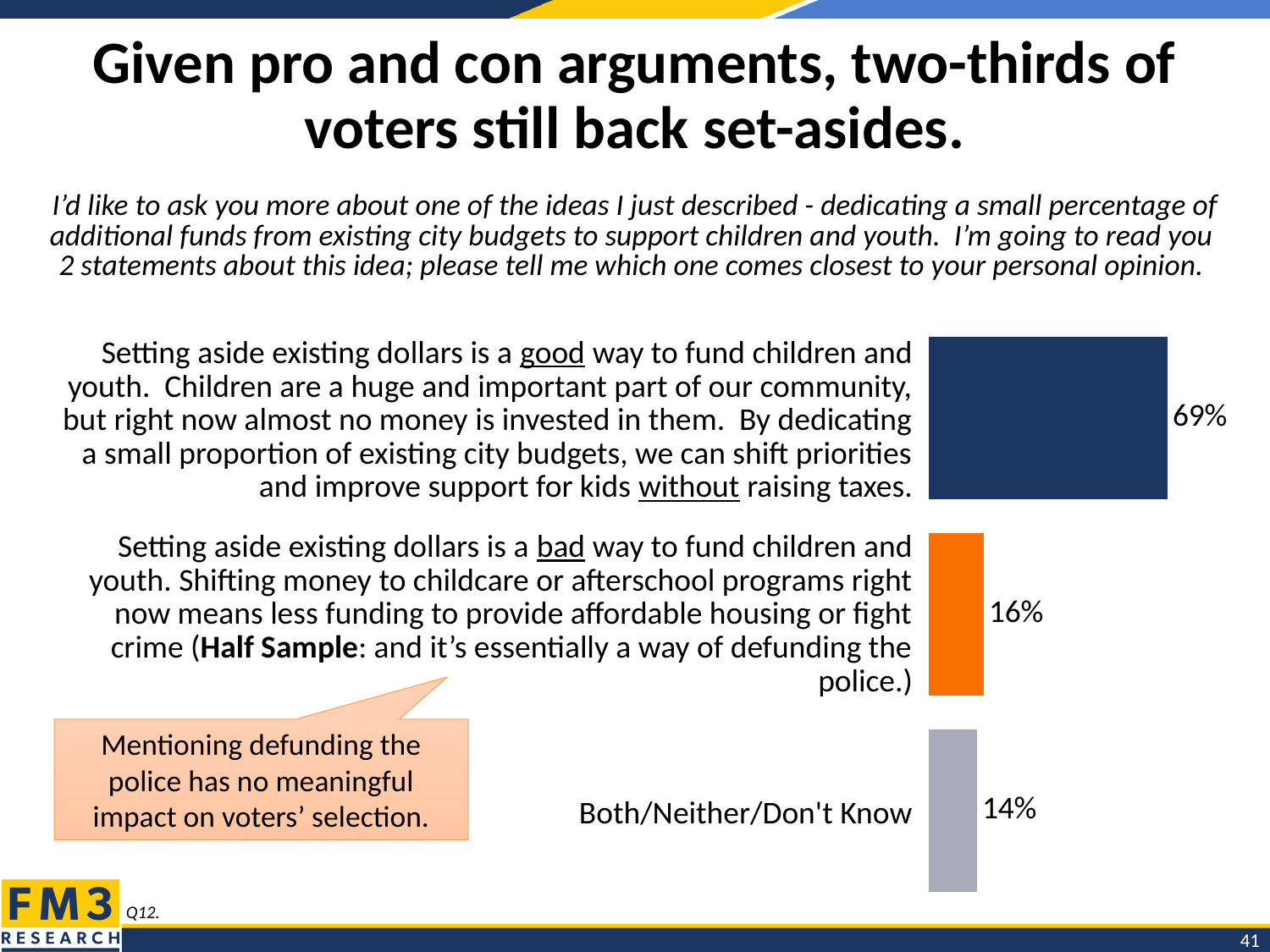
What is the difference between the 'bad way' statement and Both/Neither/Don't Know? 2 percentage points What colour is the bar for the 'bad way' statement? Orange What colour is the bar for the 'good way' statement? Dark blue What kind of chart is shown on the slide? Bar chart How many categories are shown in the chart? 3 Which is larger: the value for the 'bad way' statement or the value for Both/Neither/Don't Know? The 'bad way' statement What is the difference between the 'good way' statement and the 'bad way' statement? 53 percentage points What percentage of voters chose the statement that setting aside existing dollars is a bad way to fund children and youth? 16% Which category has the highest value? Setting aside existing dollars is a good way to fund children and youth What is the value for Both/Neither/Don't Know? 14% What percentage of voters chose the statement that setting aside existing dollars is a good way to fund children and youth? 69% Which category has the lowest value? Both/Neither/Don't Know